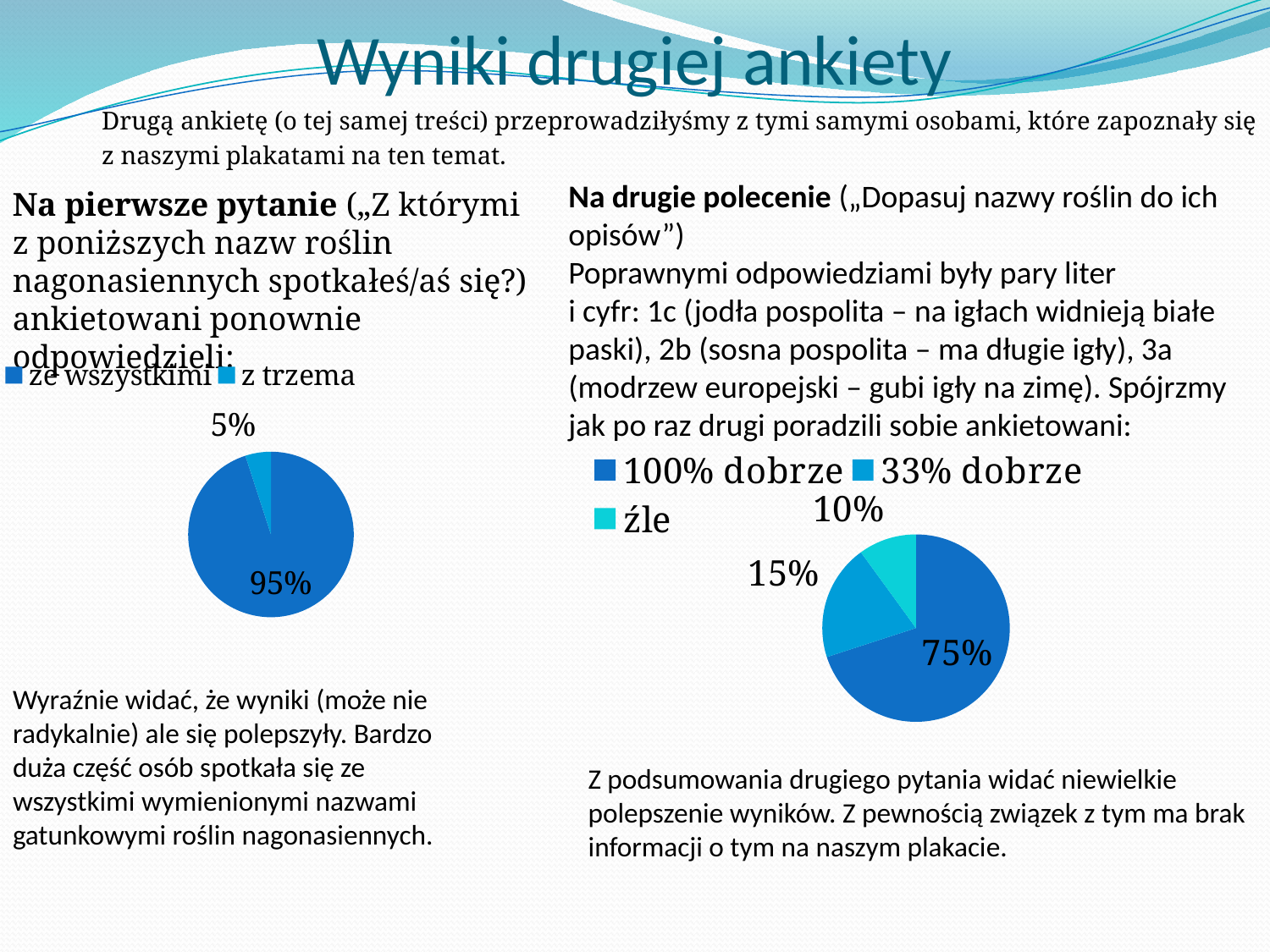
In the right pie chart, what share is labelled for "33% dobrze"? 15% In the left pie chart, what share is labelled for "z trzema"? 5% In the left pie chart, what share is labelled for "ze wszystkimi"? 95% How many slices does the right pie chart have? 3 In the left pie chart, what is the difference between the "ze wszystkimi" and "z trzema" shares? 90% In the right pie chart, which slice is the smallest? źle In the right pie chart, what share is labelled for "źle"? 10% In the right pie chart, which is larger: the "33% dobrze" slice or the "źle" slice? 33% dobrze In the left pie chart, which slice is the largest? ze wszystkimi What kind of chart is the left chart on the slide? pie chart In the right pie chart, what share is labelled for "100% dobrze"? 75% How many entries does the legend of the left pie chart list? 2